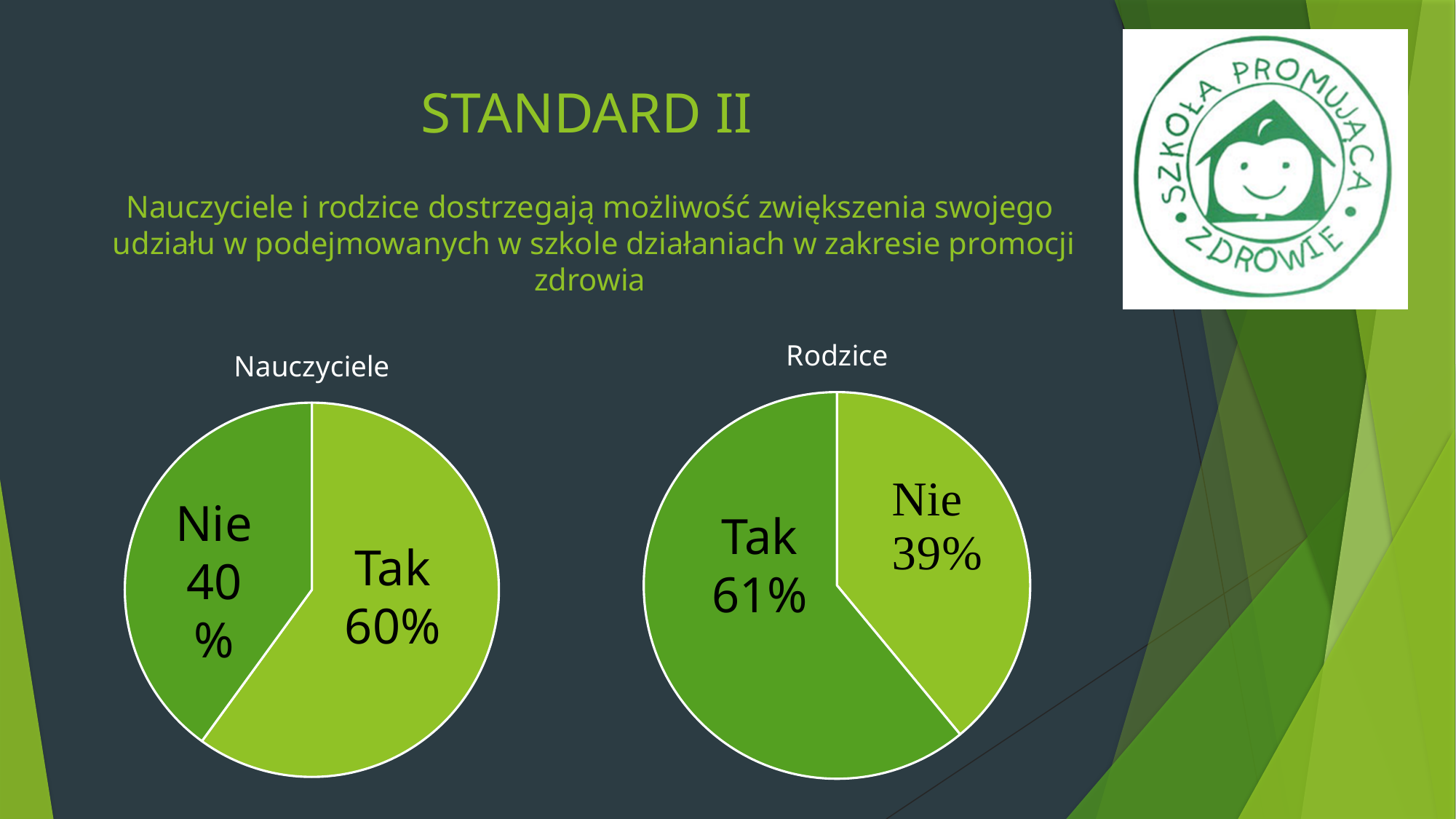
In the Nauczyciele chart, which answer has the largest slice? Tak In the Rodzice chart, what is the difference between the Tak and Nie shares? 22% In the Nauczyciele chart, what is the difference between the Tak and Nie shares? 20% What is the title of the chart on the right? Rodzice Which is larger: the Tak share in the Nauczyciele chart or the Tak share in the Rodzice chart? Rodzice In the Rodzice chart, what percentage answered Nie? 39% In the Nauczyciele chart, what percentage answered Nie? 40% In the Rodzice chart, which answer has the smallest slice? Nie In the Rodzice chart, what percentage answered Tak? 61% How many slices does the Rodzice chart have? 2 What type of chart is the Nauczyciele chart? Pie chart In the Nauczyciele chart, what percentage answered Tak? 60%